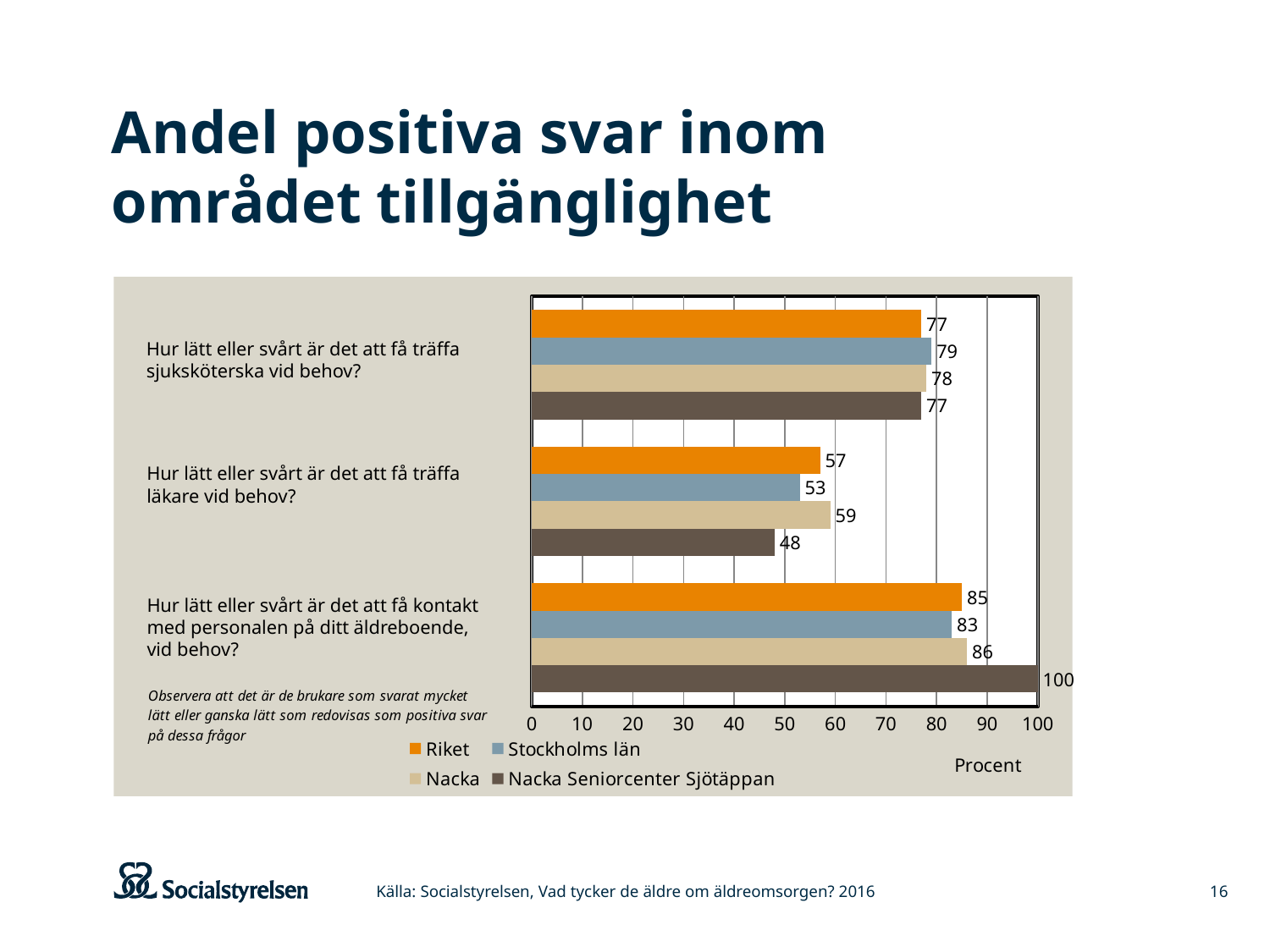
What label is shown on the x axis of the chart? Procent What is the value for Nacka Seniorcenter Sjötäppan for 'Hur lätt eller svårt är det att få kontakt med personalen på ditt äldreboende, vid behov?' 100 What is the difference between Nacka and Nacka Seniorcenter Sjötäppan for 'Hur lätt eller svårt är det att få träffa läkare vid behov?' 11 What kind of chart is shown on the slide? Bar chart What is the value for Riket for 'Hur lätt eller svårt är det att få träffa sjuksköterska vid behov?' 77 How many questions (categories) are shown on the chart? 3 What is the value for Stockholms län for 'Hur lätt eller svårt är det att få träffa läkare vid behov?' 53 Which series has the highest value for 'Hur lätt eller svårt är det att få kontakt med personalen på ditt äldreboende, vid behov?' Nacka Seniorcenter Sjötäppan How many series does the legend list? 4 Which series has the lowest value for 'Hur lätt eller svårt är det att få träffa läkare vid behov?' Nacka Seniorcenter Sjötäppan What is the difference between Nacka Seniorcenter Sjötäppan and Riket for 'Hur lätt eller svårt är det att få kontakt med personalen på ditt äldreboende, vid behov?' 15 For 'Hur lätt eller svårt är det att få träffa läkare vid behov?', which is larger: Riket or Nacka? Nacka